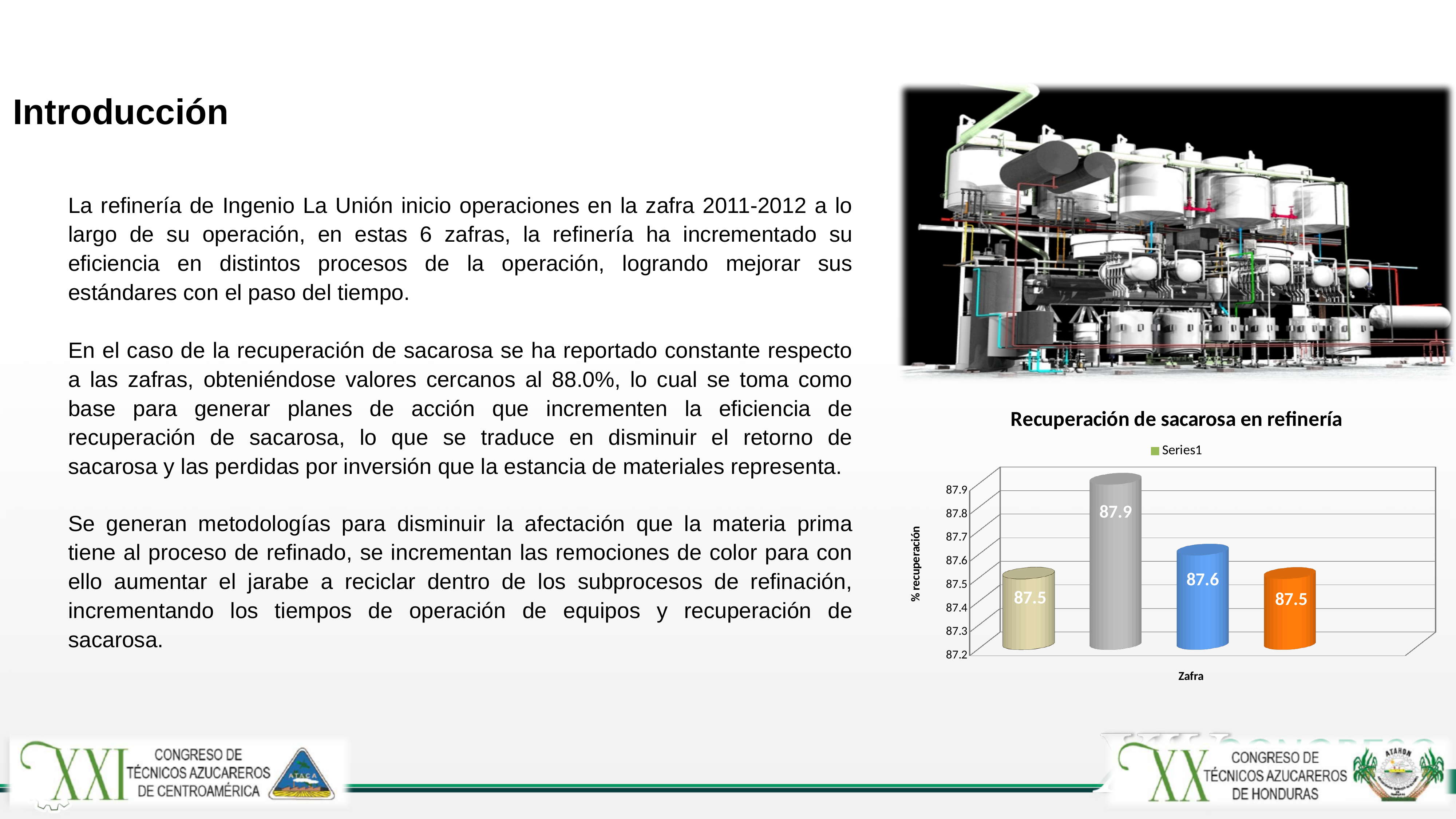
In the "Recuperación de sacarosa en refinería" chart, which is larger: the second (grey) bar or the third (blue) bar? the second (grey) bar In the "Recuperación de sacarosa en refinería" chart, what is the difference between the second (grey) bar and the third (blue) bar? 0.3 What is the value shown on the fourth (orange) bar in the "Recuperación de sacarosa en refinería" chart? 87.5 How many series does the legend of the "Recuperación de sacarosa en refinería" chart list? 1 What type of chart is shown under the title "Recuperación de sacarosa en refinería"? bar chart How many bars are plotted in the "Recuperación de sacarosa en refinería" chart? 4 What is the lowest value plotted in the "Recuperación de sacarosa en refinería" chart? 87.5 What is the value shown on the first (leftmost, beige) bar in the "Recuperación de sacarosa en refinería" chart? 87.5 What is the value shown on the third (blue) bar in the "Recuperación de sacarosa en refinería" chart? 87.6 What is the label of the vertical axis in the "Recuperación de sacarosa en refinería" chart? % recuperación What is the value shown on the second (grey) bar in the "Recuperación de sacarosa en refinería" chart? 87.9 What is the highest value plotted in the "Recuperación de sacarosa en refinería" chart? 87.9